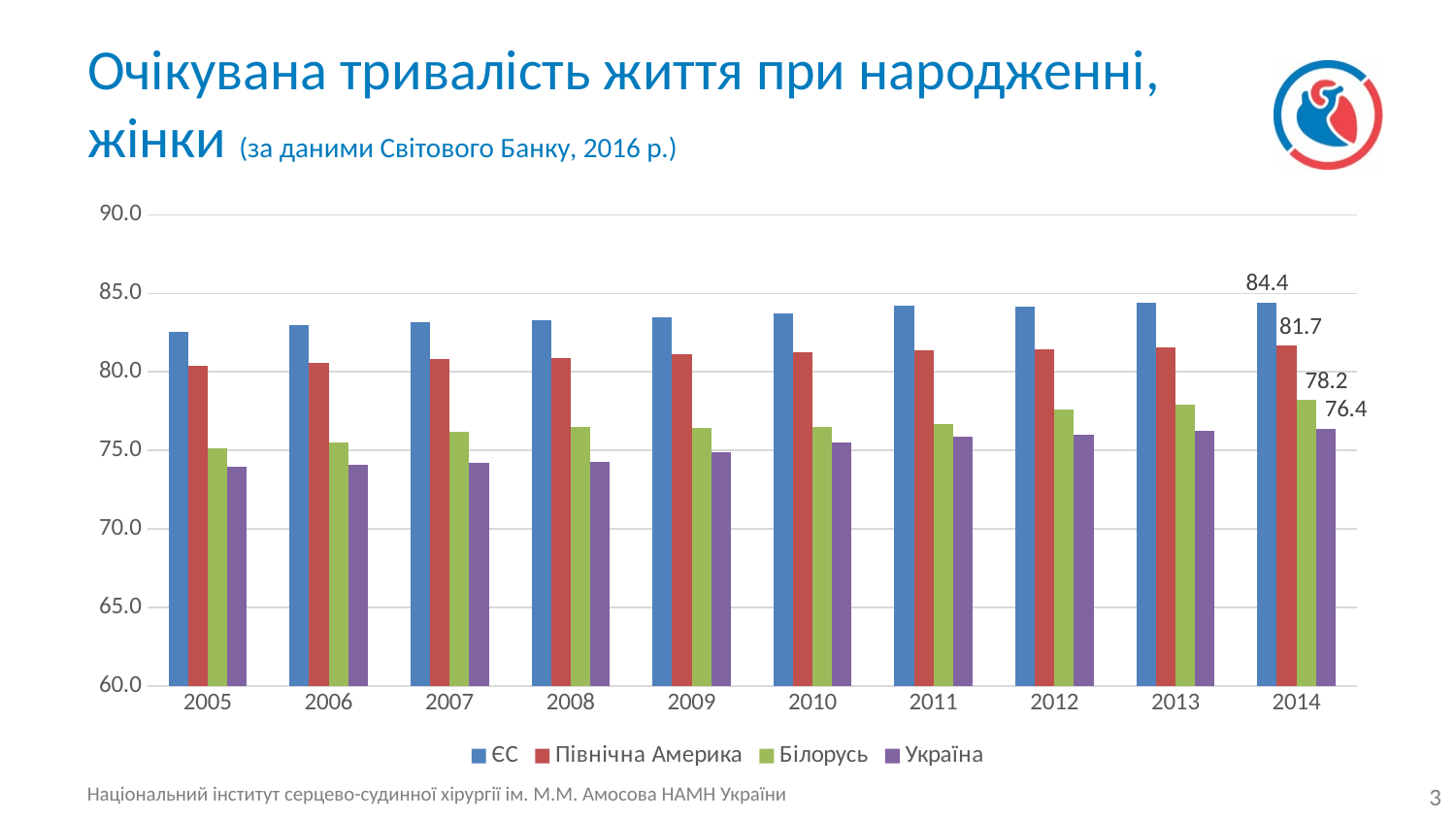
What is the value for Північна Америка in 2014? 81.7 What is the value for ЄС in 2014? 84.4 How many years are shown on the x axis? 10 Which series has the lowest value in 2005? Україна What is the value for Україна in 2014? 76.4 Is the value for Україна in 2005 greater or less than 75.0? less How many series does the legend list? 4 What is the difference between the ЄС and Україна values in 2014? 8.0 Is the value for ЄС in 2010 greater or less than 80.0? greater What is the value for Білорусь in 2014? 78.2 Which series has the highest value in 2014? ЄС Do the values for Україна rise or fall from 2005 to 2014? rise